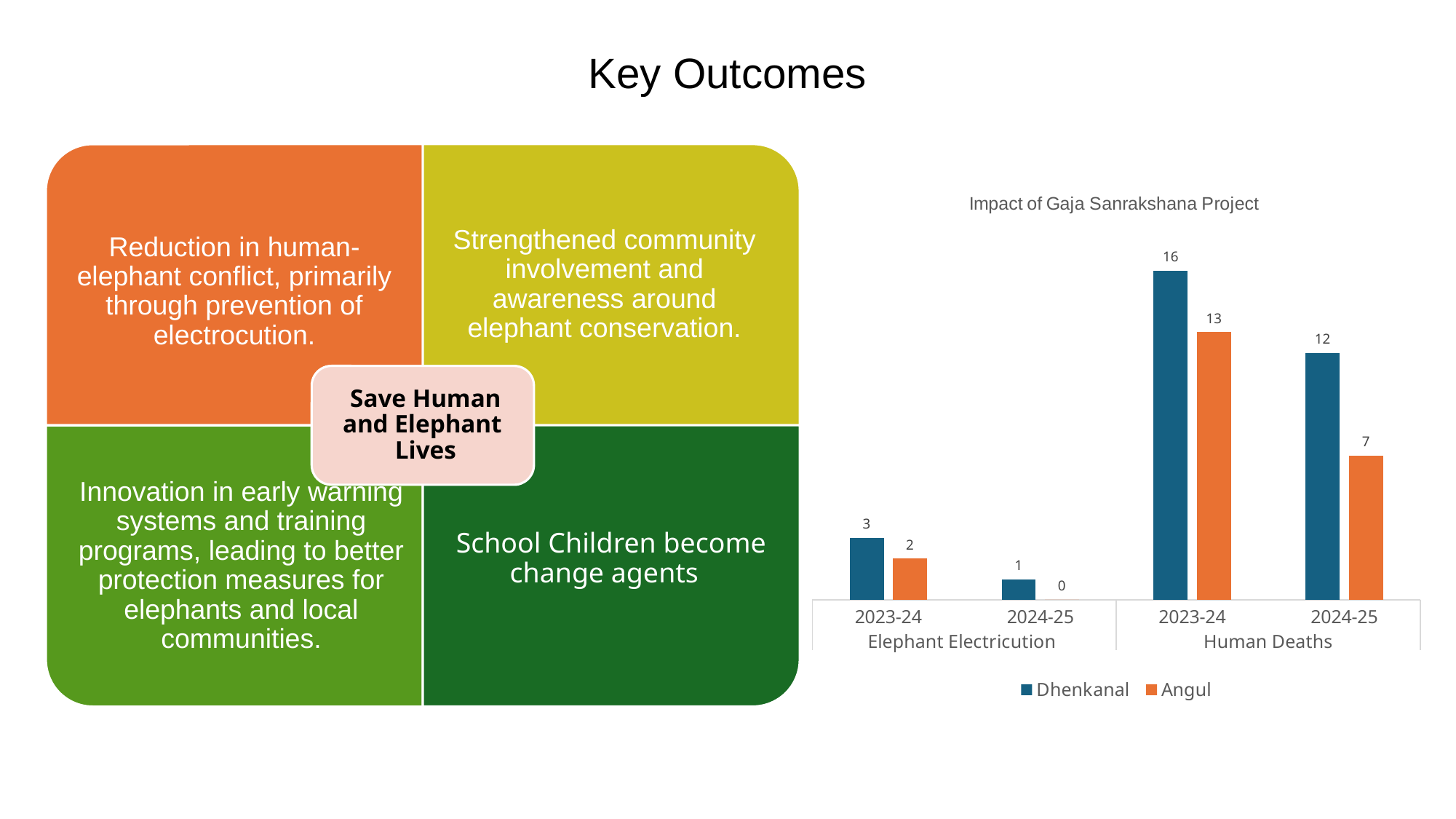
What is the title of the chart? Impact of Gaja Sanrakshana Project Which category and year has the highest value for Dhenkanal? Human Deaths 2023-24 Do the Angul Human Deaths values rise or fall from 2023-24 to 2024-25? Fall What is the value for Angul in Human Deaths for 2024-25? 7 What is the difference between Dhenkanal Human Deaths in 2023-24 and 2024-25? 4 What is the value for Dhenkanal in Elephant Electricution for 2023-24? 3 What is the value for Angul in Elephant Electricution for 2024-25? 0 What kind of chart is shown on the slide? Bar chart Which is larger in Human Deaths for 2023-24, Dhenkanal or Angul? Dhenkanal What is the value for Dhenkanal in Human Deaths for 2023-24? 16 How many series does the legend list? 2 What is the difference between Dhenkanal and Angul in Human Deaths for 2024-25? 5